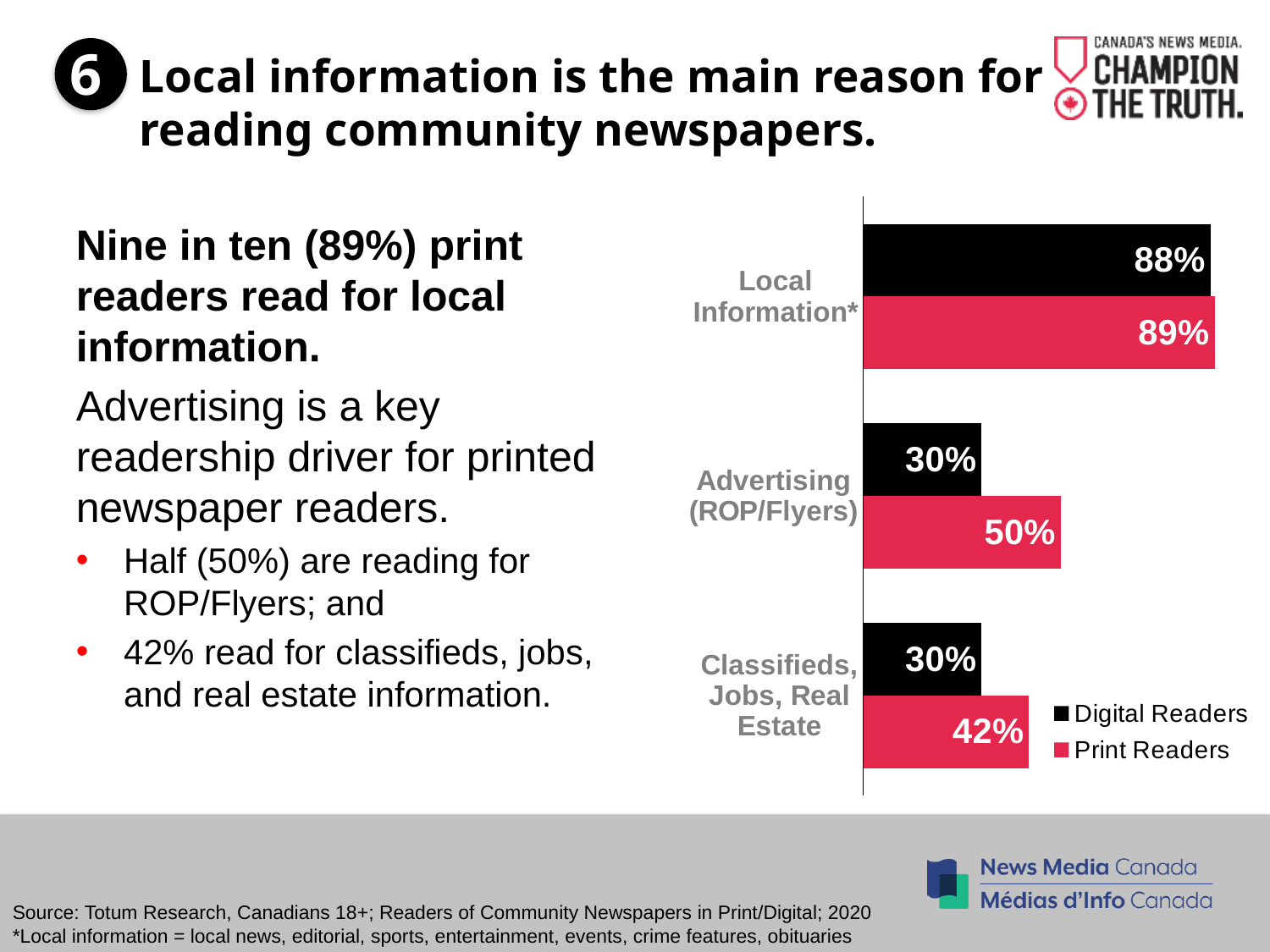
What percentage of Digital Readers read for Local Information? 88% How many series does the legend list? 2 How many categories are shown in the chart? 3 Which is larger for Advertising (ROP/Flyers): Digital Readers or Print Readers? Print Readers Which category has the lowest value for Print Readers? Classifieds, Jobs, Real Estate What is the difference between Print Readers and Digital Readers for Advertising (ROP/Flyers)? 20% What percentage of Digital Readers read for Advertising (ROP/Flyers)? 30% What percentage of Print Readers read for Local Information? 89% What percentage of Print Readers read for Classifieds, Jobs, Real Estate? 42% What is the difference between Print Readers and Digital Readers for Classifieds, Jobs, Real Estate? 12% Which category has the highest value for Print Readers? Local Information What kind of chart is shown on the slide? Bar chart